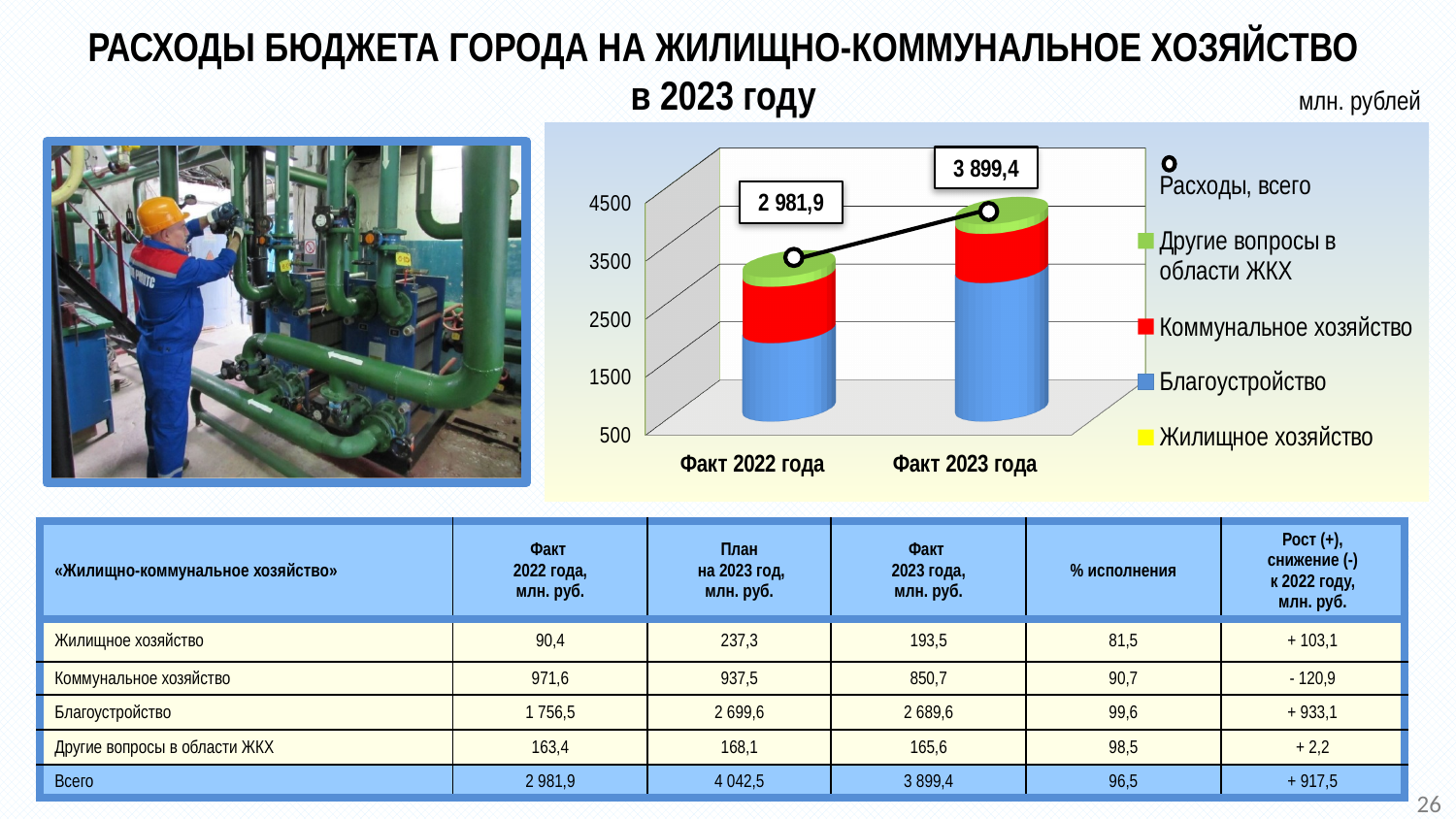
How many entries does the chart legend list? 5 How many categories are shown on the x axis of the chart? 2 Does the total expenditure rise or fall from 'Факт 2022 года' to 'Факт 2023 года'? rise Is the 'Расходы, всего' value for 'Факт 2023 года' greater or less than 3500? greater Is the 'Расходы, всего' value for 'Факт 2022 года' larger or smaller than the value for 'Факт 2023 года'? smaller Is the 'Расходы, всего' value for 'Факт 2022 года' greater or less than 3500? less What is the value of the 'Расходы, всего' data label for 'Факт 2022 года'? 2 981,9 What kind of chart is shown on the slide? bar chart What is the value of the 'Расходы, всего' data label for 'Факт 2023 года'? 3 899,4 What is the difference between the 'Расходы, всего' values for 'Факт 2023 года' and 'Факт 2022 года'? 917,5 Which category has the lower total expenditure ('Расходы, всего')? Факт 2022 года Which category has the higher total expenditure ('Расходы, всего')? Факт 2023 года